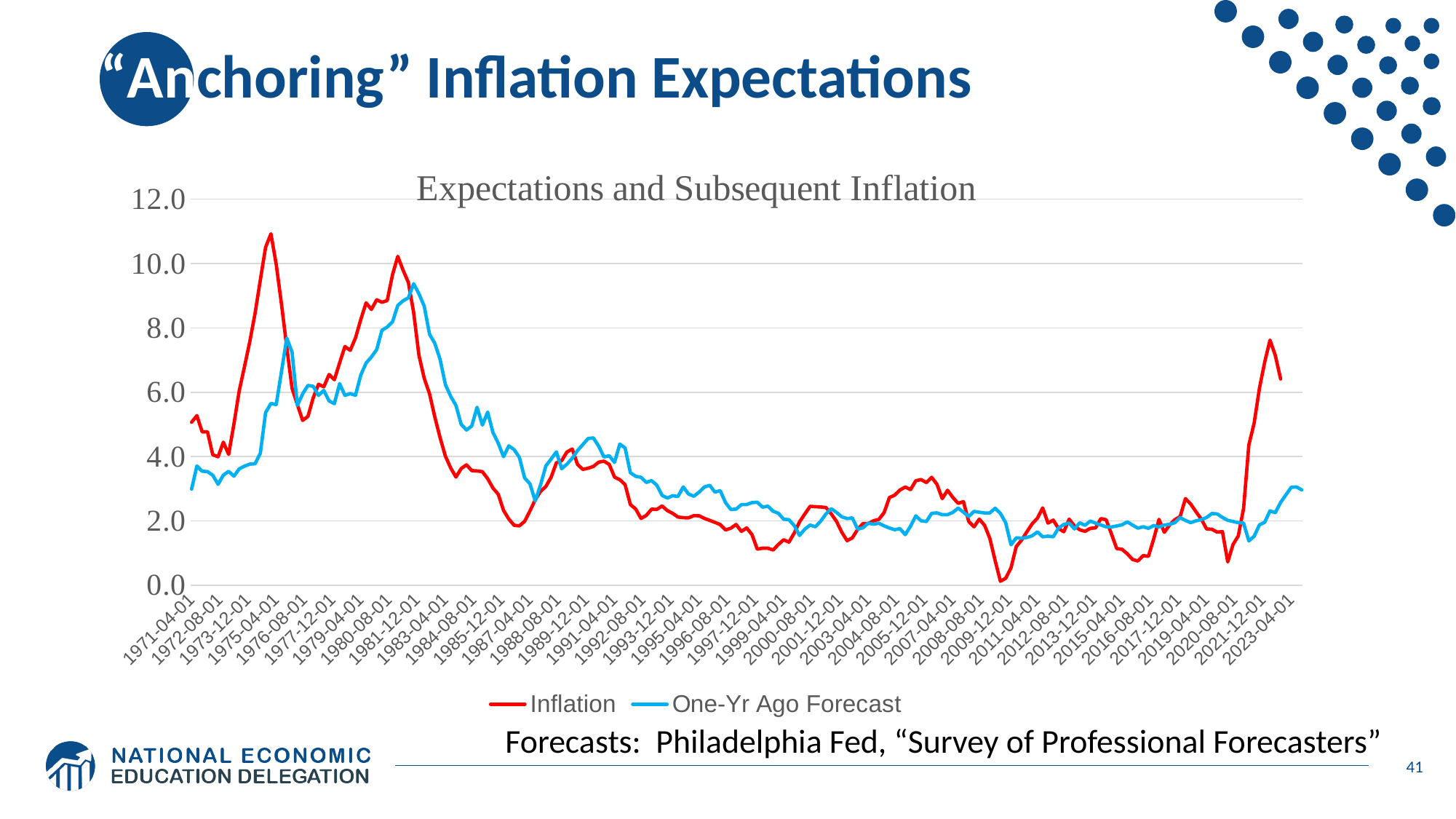
Which series reaches the highest value anywhere on the chart? Inflation Around 2021-12-01, which series is higher, Inflation or One-Yr Ago Forecast? Inflation How many series does the legend list? 2 Is the Inflation value around 2021-12-01 greater or less than 6.0? greater What kind of chart is shown on the slide? Line chart What is the title of the chart? Expectations and Subsequent Inflation Which colour is used for the One-Yr Ago Forecast series? Blue Is the peak value of the Inflation series around 1975 greater or less than 10.0? greater Does the Inflation series rise or fall between 2020-08-01 and 2021-12-01? Rise What is the highest value shown on the y axis? 12.0 Is the Inflation value around 2009-12-01 greater or less than 2.0? less